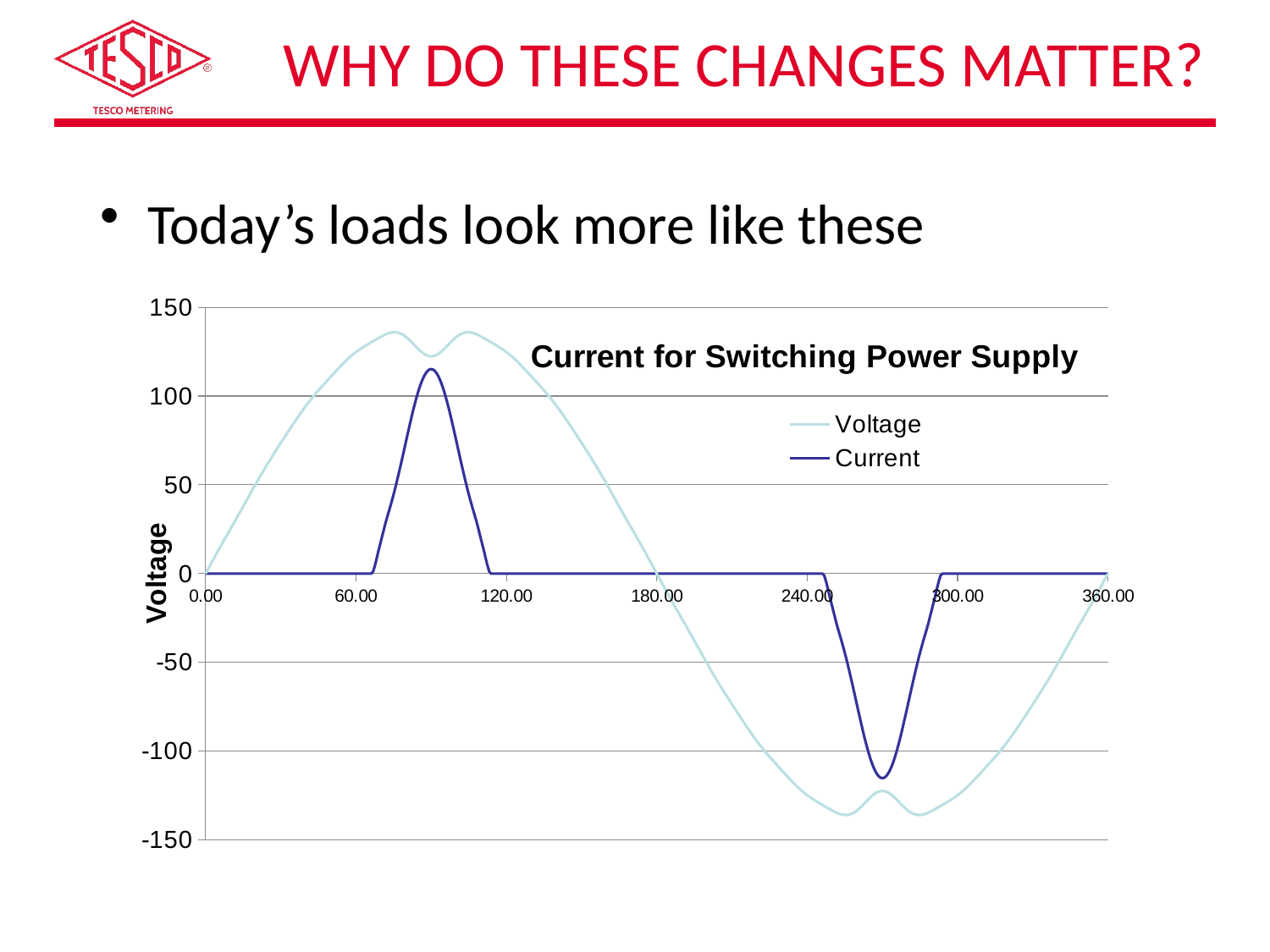
Does the Voltage series rise or fall between 0.00 and 60.00 on the x axis? rise What are the two series named in the chart legend? Voltage and Current What is the title of the chart? Current for Switching Power Supply What is the value of the Voltage series at 180.00 on the x axis? 0 Is the peak value of the Voltage series greater or less than 100? greater Is the lowest value of the Voltage series greater or less than -100? less What is the value of the Current series at 0.00 on the x axis? 0 Which series reaches the lower minimum value, Voltage or Current? Voltage How many series does the chart legend list? 2 Is the peak value of the Current series greater or less than 150? less Which series reaches the higher peak value, Voltage or Current? Voltage What kind of chart is shown on the slide? line chart